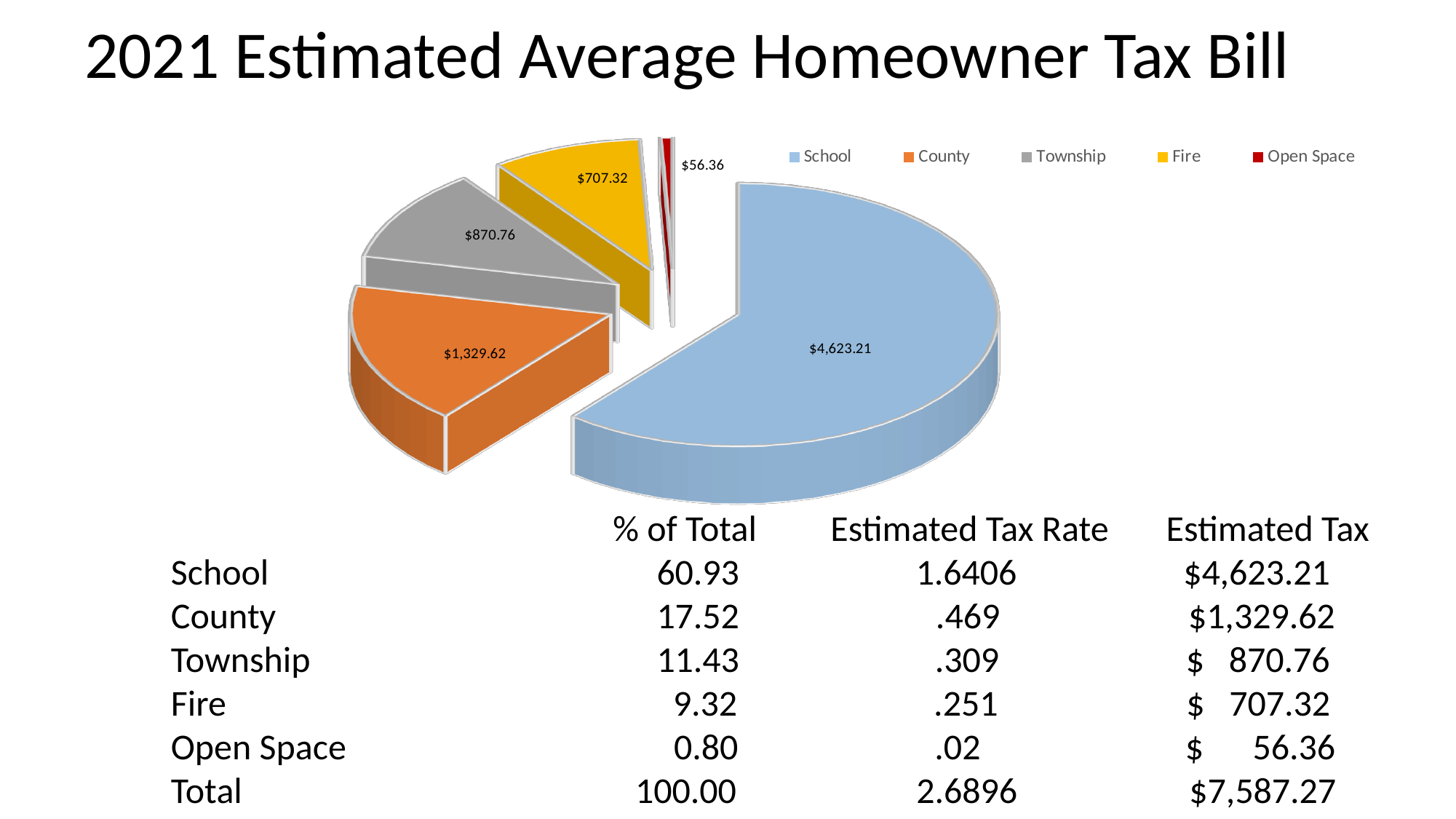
Which is larger in the pie chart, Township or Fire? Township Which category has the largest slice in the pie chart? School What is the value of the County slice in the pie chart? $1,329.62 What is the value of the Township slice in the pie chart? $870.76 What is the value of the Fire slice in the pie chart? $707.32 What is the value of the School slice in the pie chart? $4,623.21 What is the value of the Open Space slice in the pie chart? $56.36 Which category has the smallest slice in the pie chart? Open Space How many categories does the legend of the pie chart list? 5 How much larger is the School value than the County value in the pie chart? $3,293.59 What share of the total does the School slice represent? 60.93% What type of chart is shown on the slide? pie chart